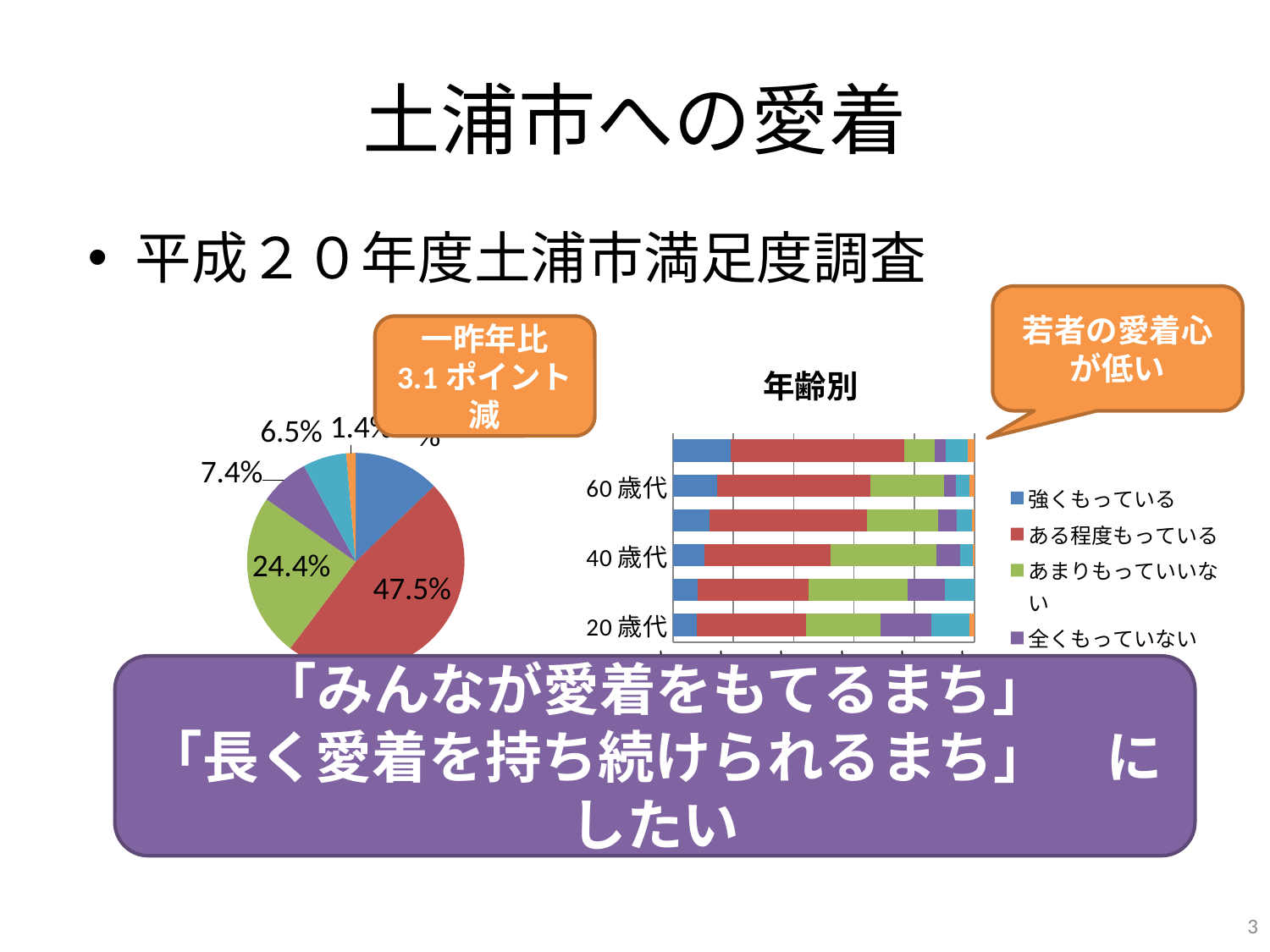
How many bars are plotted in the chart titled 年齢別? 6 In the pie chart on the left, what is the difference between the 47.5% slice and the 24.4% slice? 23.1 percentage points In the pie chart on the left, what is the value of the purple slice? 7.4% In the pie chart on the left, which is larger, the purple slice or the cyan slice? the purple slice (7.4%) In the chart titled 年齢別, which has the larger 強くもっている segment, 60歳代 or 20歳代? 60歳代 In the chart titled 年齢別, which colour represents ある程度もっている in the legend? red What kind of chart is the chart titled 年齢別? stacked bar chart What is the title of the bar chart on the right? 年齢別 In the pie chart on the left, what is the value of the green slice? 24.4% In the pie chart on the left, what is the value of the largest slice? 47.5% In the pie chart on the left, what is the value of the smallest labelled slice? 1.4% What kind of chart is the chart on the left of the slide? pie chart